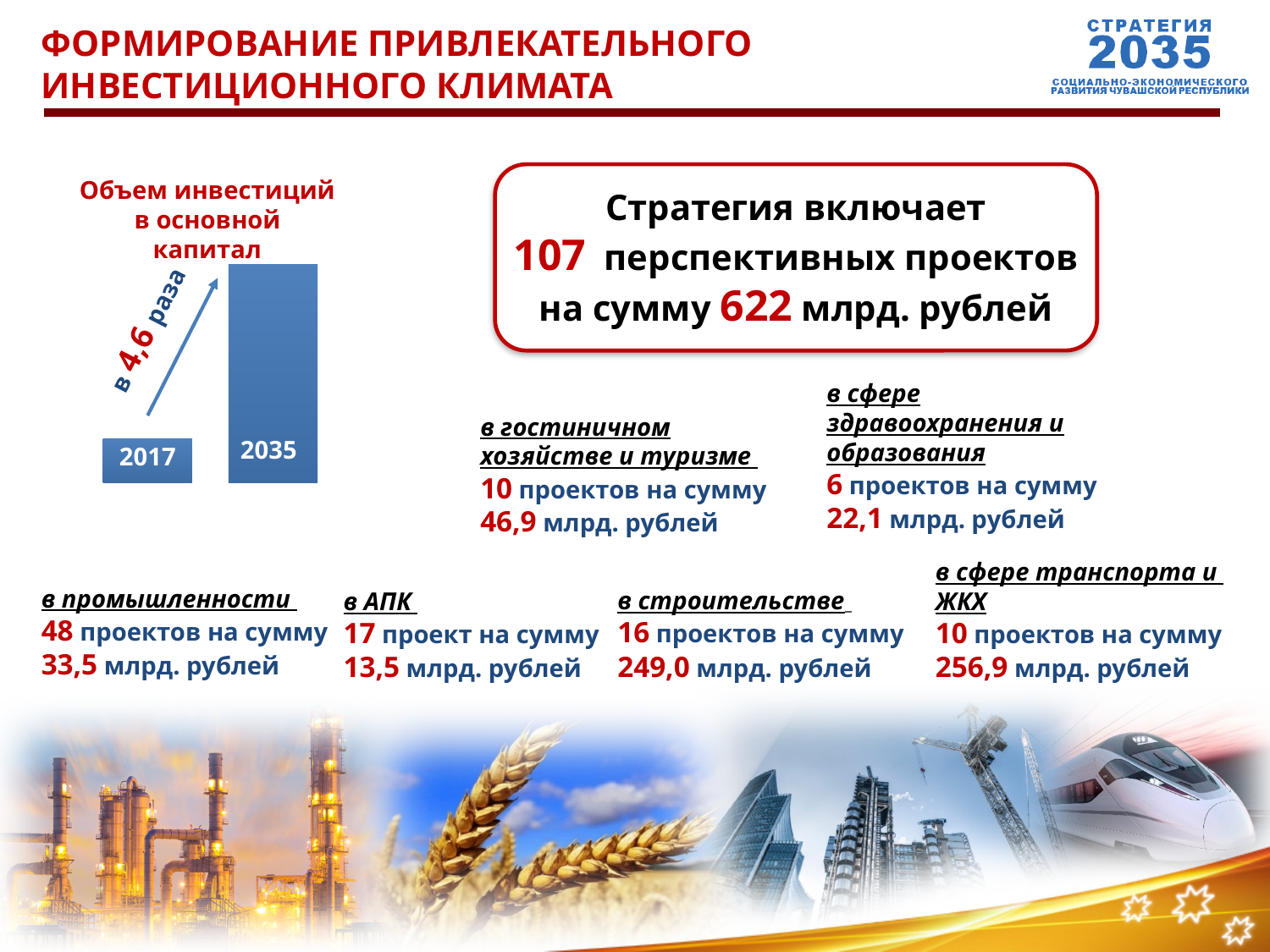
What is the title of the bar chart on the left of the slide? Объем инвестиций в основной капитал Do the values in the chart "Объем инвестиций в основной капитал" rise or fall from 2017 to 2035? rise According to the annotation on the chart "Объем инвестиций в основной капитал", by what factor does the value grow from 2017 to 2035? в 4,6 раза In the chart "Объем инвестиций в основной капитал", which year has the shorter bar? 2017 What are the two category labels on the x axis of the chart "Объем инвестиций в основной капитал"? 2017 and 2035 In the chart "Объем инвестиций в основной капитал", is the bar for 2035 larger or smaller than the bar for 2017? larger How many bars does the chart "Объем инвестиций в основной капитал" have? 2 In the chart "Объем инвестиций в основной капитал", which year has the taller bar? 2035 What kind of chart is shown under the title "Объем инвестиций в основной капитал"? bar chart